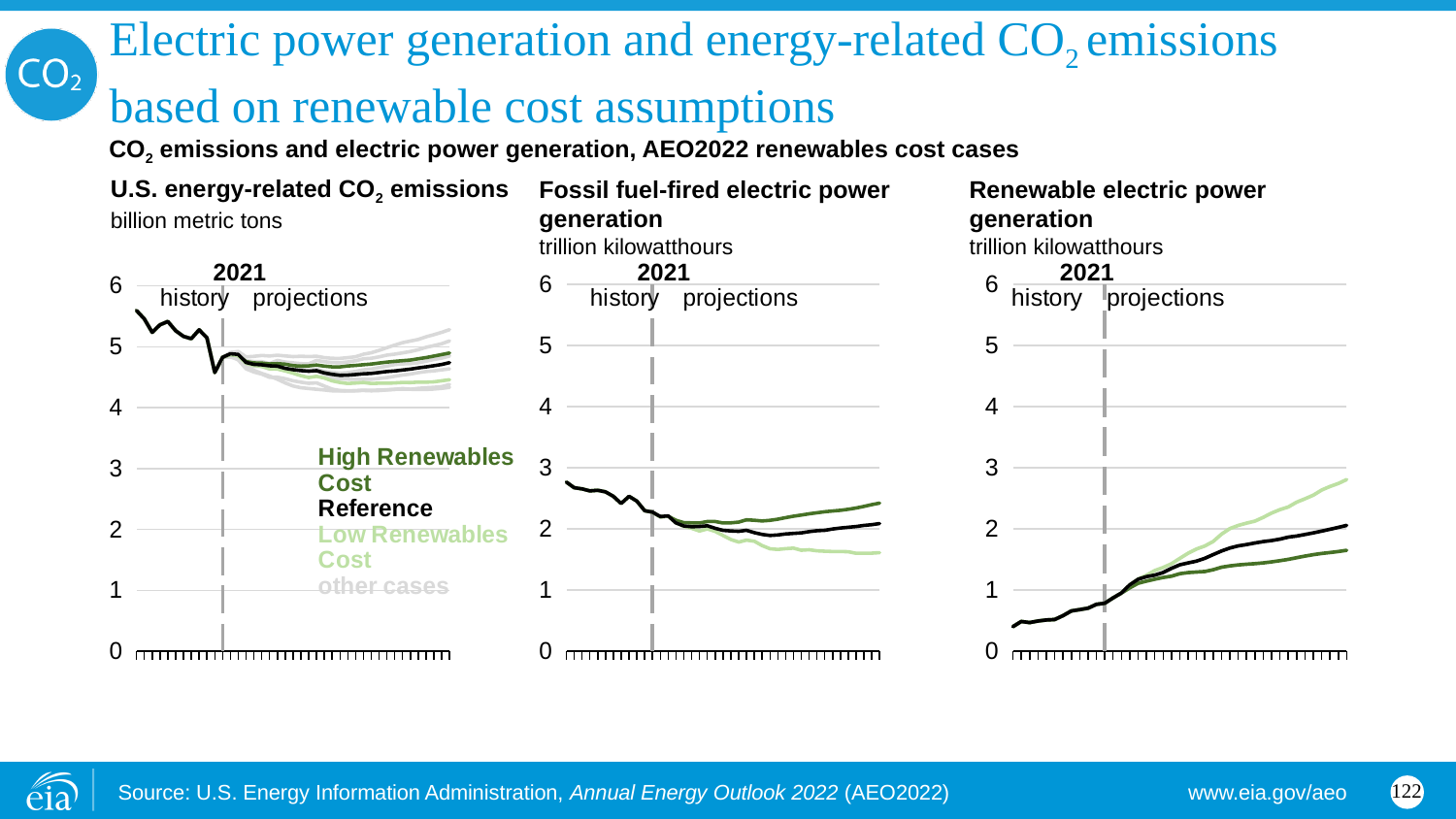
In the Renewable electric power generation chart, which case ends higher at the end of the projection period, Low Renewables Cost or High Renewables Cost? Low Renewables Cost What kind of chart is the U.S. energy-related CO2 emissions chart? line chart In the Renewable electric power generation chart, is the final projected value for the Low Renewables Cost case greater or less than 2? greater In the Fossil fuel-fired electric power generation chart, do the values rise or fall from the start of history to 2021? fall What year does the dashed vertical line separating history from projections mark on the charts? 2021 In the Fossil fuel-fired electric power generation chart, is the final projected value for the Low Renewables Cost case greater or less than 2? less In the Renewable electric power generation chart, is the final projected value for the High Renewables Cost case greater or less than 2? less In the Fossil fuel-fired electric power generation chart, which case ends higher at the end of the projection period, High Renewables Cost or Low Renewables Cost? High Renewables Cost How many charts are shown on the slide? 3 In the Renewable electric power generation chart, do the values rise or fall over time? rise How many cases does the legend on the U.S. energy-related CO2 emissions chart list? 4